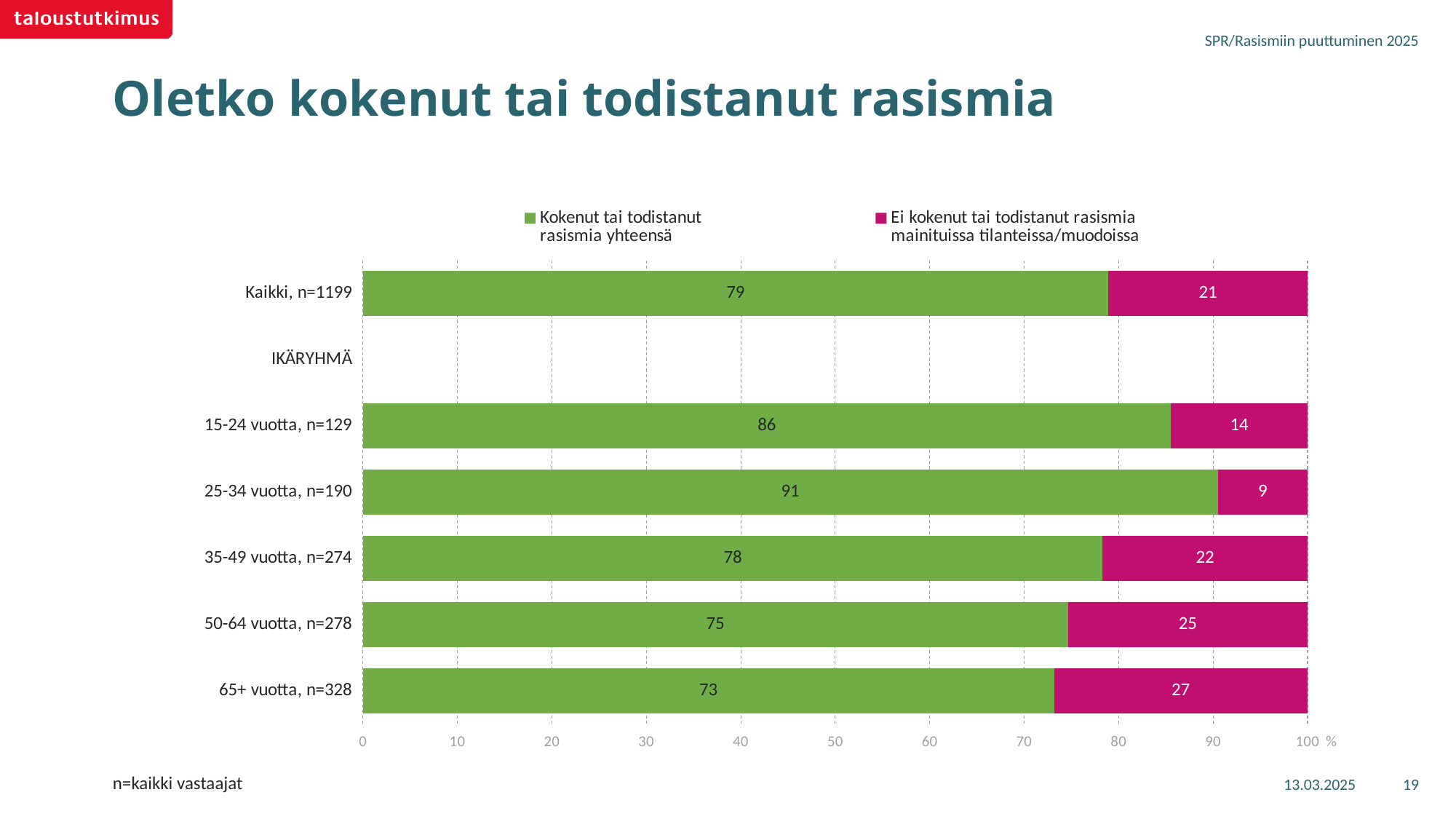
Which has a larger "Ei kokenut tai todistanut rasismia mainituissa tilanteissa/muodoissa" value: "Kaikki, n=1199" or "65+ vuotta, n=328"? 65+ vuotta, n=328 Which age group has the highest value for "Kokenut tai todistanut rasismia yhteensä"? 25-34 vuotta, n=190 What is the total of the stacked bar for "35-49 vuotta, n=274"? 100 What kind of chart is shown on the slide? Stacked bar chart What is the difference between the "Kokenut tai todistanut rasismia yhteensä" values for "15-24 vuotta, n=129" and "35-49 vuotta, n=274"? 8 What colour represents "Ei kokenut tai todistanut rasismia mainituissa tilanteissa/muodoissa" in the chart? Magenta (pink) What is the value of "Ei kokenut tai todistanut rasismia mainituissa tilanteissa/muodoissa" for "25-34 vuotta, n=190"? 9 Do the "Kokenut tai todistanut rasismia yhteensä" values rise or fall from the "25-34 vuotta" group down to the "65+ vuotta" group? Fall How many series does the legend list? 2 What is the value of "Kokenut tai todistanut rasismia yhteensä" for "50-64 vuotta, n=278"? 75 Which age group has the lowest value for "Kokenut tai todistanut rasismia yhteensä"? 65+ vuotta, n=328 What is the value of "Kokenut tai todistanut rasismia yhteensä" for "Kaikki, n=1199"? 79